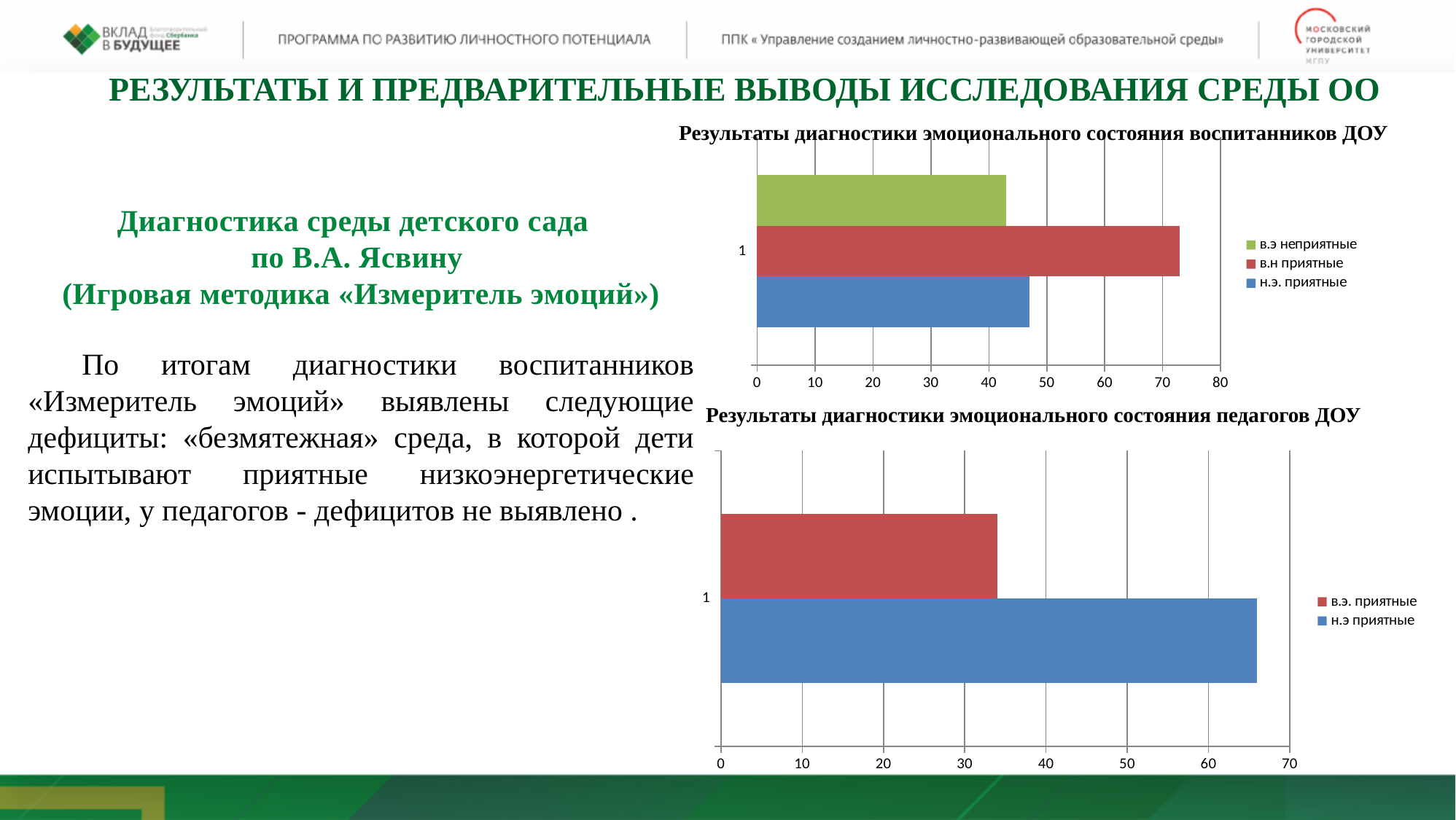
In the top chart (воспитанников ДОУ), which series has the highest value? в.н приятные How many series does the legend of the bottom chart (педагогов ДОУ) list? 2 How many series does the legend of the top chart (воспитанников ДОУ) list? 3 What is the title of the bottom chart on the slide? Результаты диагностики эмоционального состояния педагогов ДОУ What kind of chart is the top chart, 'Результаты диагностики эмоционального состояния воспитанников ДОУ'? Bar chart In the bottom chart (педагогов ДОУ), which series has the highest value? н.э приятные In the top chart (воспитанников ДОУ), is the value for 'в.э неприятные' greater or less than 50? less In the bottom chart (педагогов ДОУ), is the value for 'в.э. приятные' greater or less than 40? less In the top chart (воспитанников ДОУ), which is larger: 'н.э. приятные' or 'в.н приятные'? в.н приятные In the bottom chart (педагогов ДОУ), is the value for 'н.э приятные' greater or less than 60? greater In the top chart (воспитанников ДОУ), which series has the lowest value? в.э неприятные